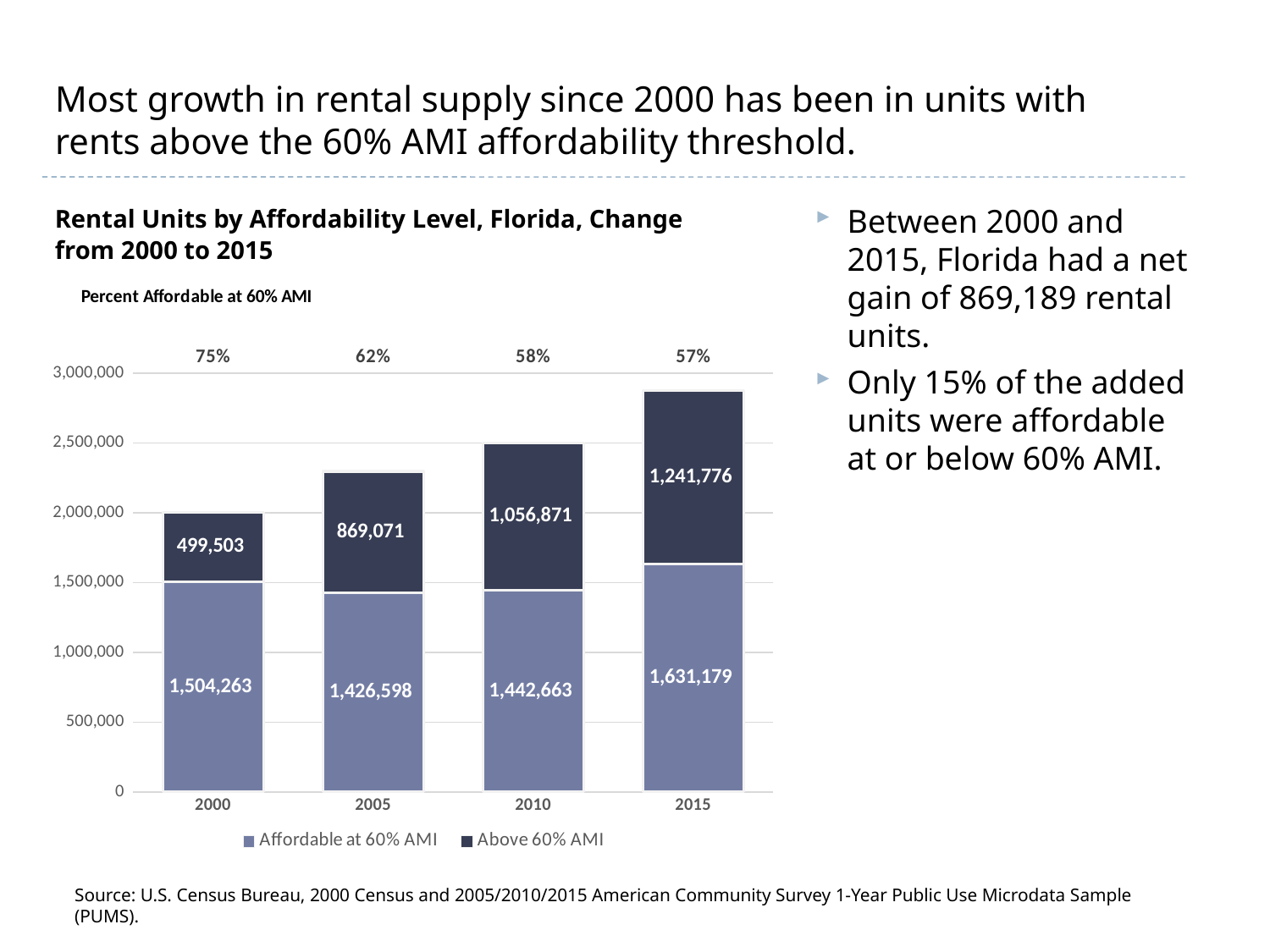
What is the value for Affordable at 60% AMI in 2000? 1,504,263 What is the total of the stacked bar for 2015? 2,872,955 Which year has the lowest value for Affordable at 60% AMI? 2005 What kind of chart is shown? Stacked bar chart What is the difference between the Above 60% AMI values for 2015 and 2000? 742,273 Which is larger, the Affordable at 60% AMI value in 2010 or the Above 60% AMI value in 2010? Affordable at 60% AMI in 2010 How many years are shown on the x axis? 4 What is the value for Above 60% AMI in 2005? 869,071 What is the value for Above 60% AMI in 2015? 1,241,776 How many series does the legend list? 2 Which year has the highest value for Above 60% AMI? 2015 What percent of rental units were affordable at 60% AMI in 2010? 58%